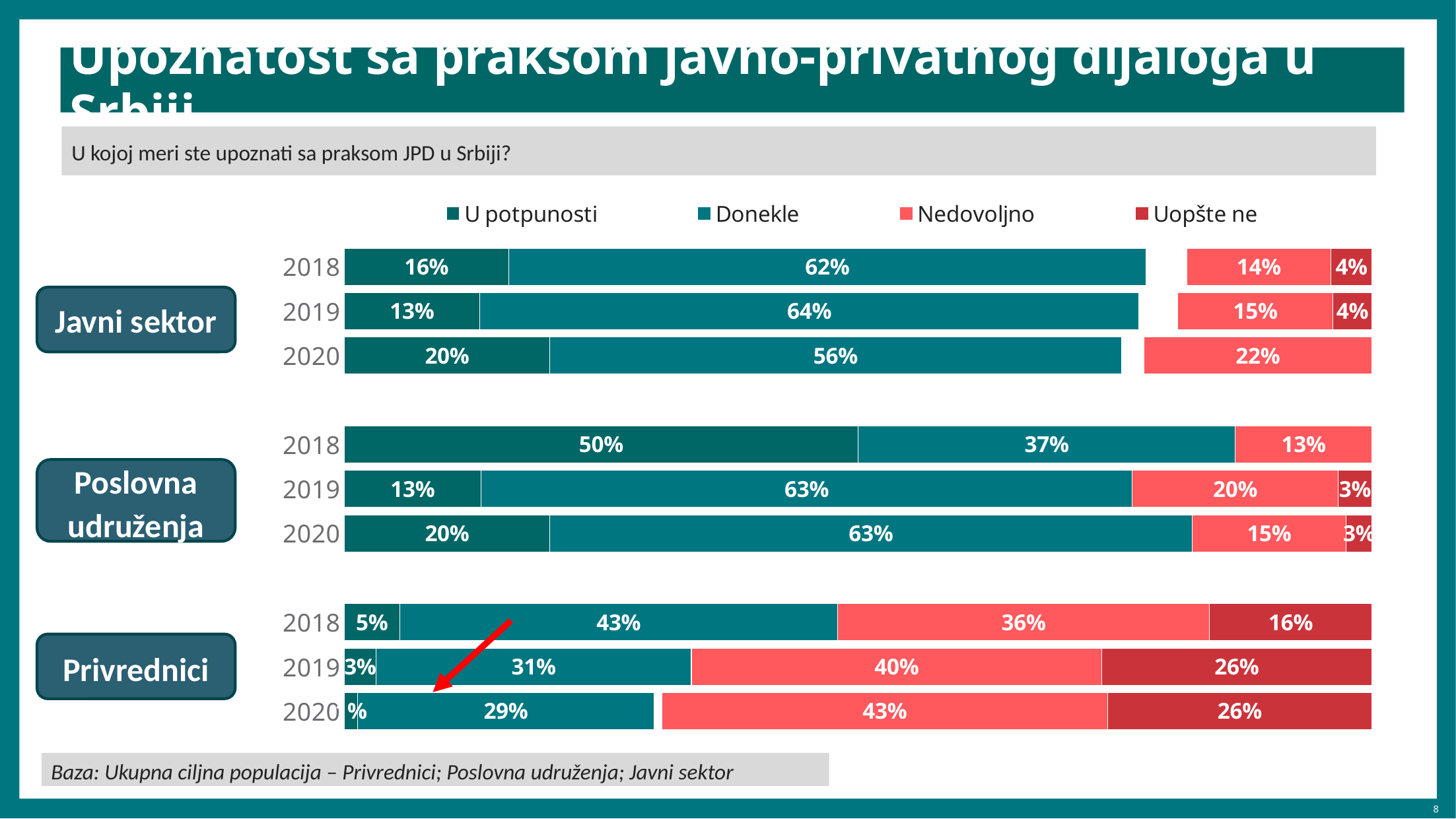
In the Javni sektor chart, what is the value for Donekle in 2019? 64% In the Poslovna udruženja chart, what is the difference between the U potpunosti values for 2018 and 2019? 37% In the Privrednici chart, which is larger in 2018: Donekle or Nedovoljno? Donekle In the Privrednici chart, what is the value for Nedovoljno in 2020? 43% How many series does the legend list? 4 In the Javni sektor chart, which year has the highest value for U potpunosti? 2020 What kind of chart is used on this slide? Stacked bar chart In the Poslovna udruženja chart, what is the value for U potpunosti in 2018? 50% In the Privrednici chart, does the Nedovoljno value rise or fall from 2018 to 2020? Rise In the Privrednici chart, which year has the lowest value for Nedovoljno? 2018 In the Privrednici chart, what is the value for Uopšte ne in 2019? 26% In the Javni sektor chart, what is the value for Nedovoljno in 2020? 22%